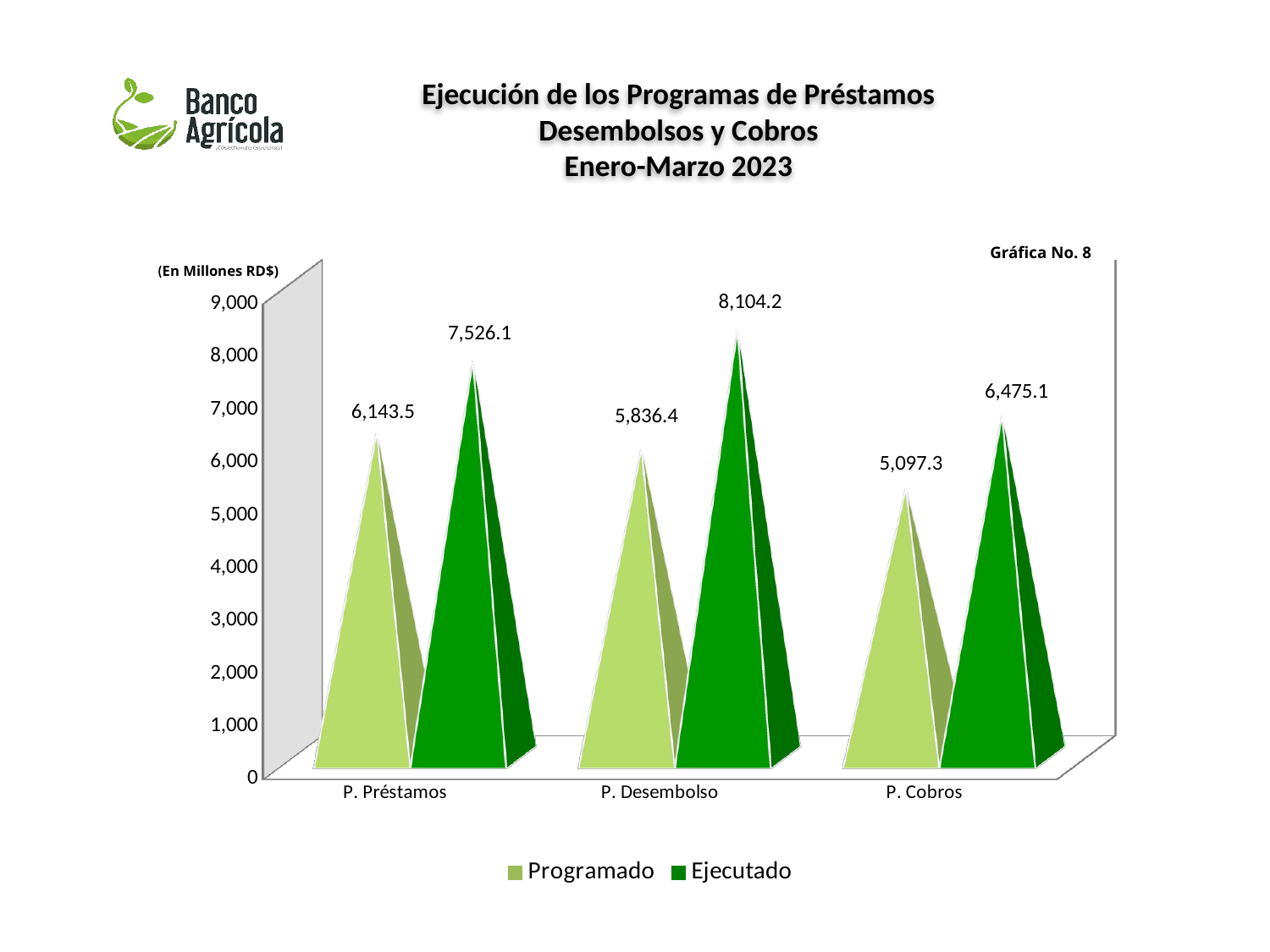
What is the difference between the Ejecutado and Programado values for P. Préstamos? 1,382.6 How many series does the legend list? 2 Which category has the lowest Programado value? P. Cobros What is the Programado value for P. Cobros? 5,097.3 What is the Ejecutado value for P. Desembolso? 8,104.2 What unit is stated for the values in the chart? En Millones RD$ What is the Programado value for P. Préstamos? 6,143.5 Which category has the highest Ejecutado value? P. Desembolso Which is larger for P. Cobros, the Programado value or the Ejecutado value? Ejecutado What is the Ejecutado value for P. Cobros? 6,475.1 What is the difference between the Ejecutado and Programado values for P. Desembolso? 2,267.8 How many categories are shown on the x axis? 3